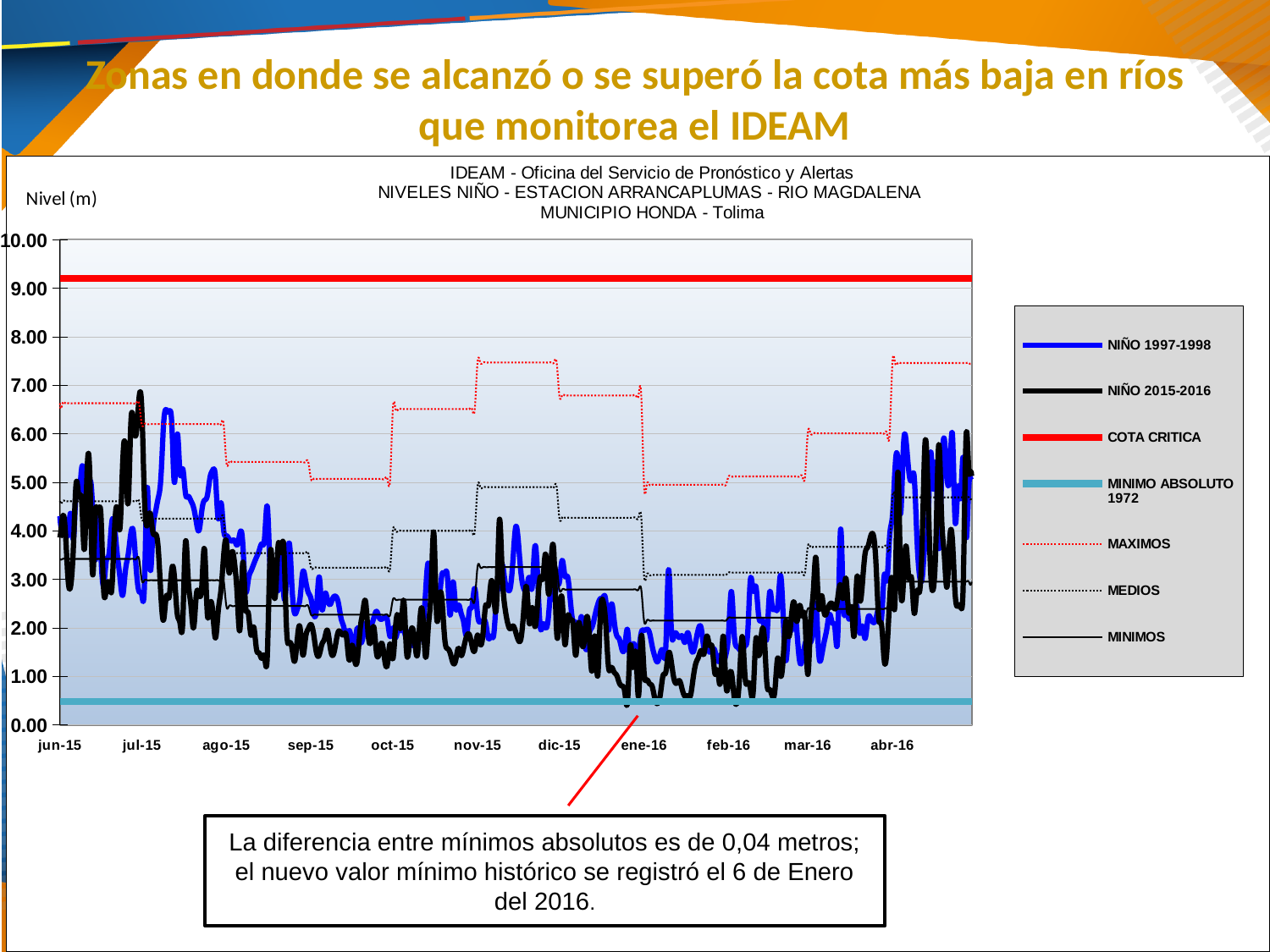
According to the text box below the chart, what is the difference between the absolute minimums? 0,04 metros What kind of chart is shown on the slide? line chart Which series in the chart sits highest on the y axis across the whole period? COTA CRITICA How many month labels are shown along the x axis of the chart? 11 At nov-15, which is higher in the chart: the MAXIMOS line or the MEDIOS line? MAXIMOS What is the label of the y axis of the chart? Nivel (m) Does the NIÑO 2015-2016 line rise or fall between ene-16 and abr-16? rise Which series in the chart sits lowest on the y axis across the whole period? MINIMO ABSOLUTO 1972 Is the value of the COTA CRITICA line greater or less than 9.00? greater Is the value of the MINIMO ABSOLUTO 1972 line greater or less than 1.00? less How many series does the chart legend list? 7 What colour is the COTA CRITICA line in the chart? red